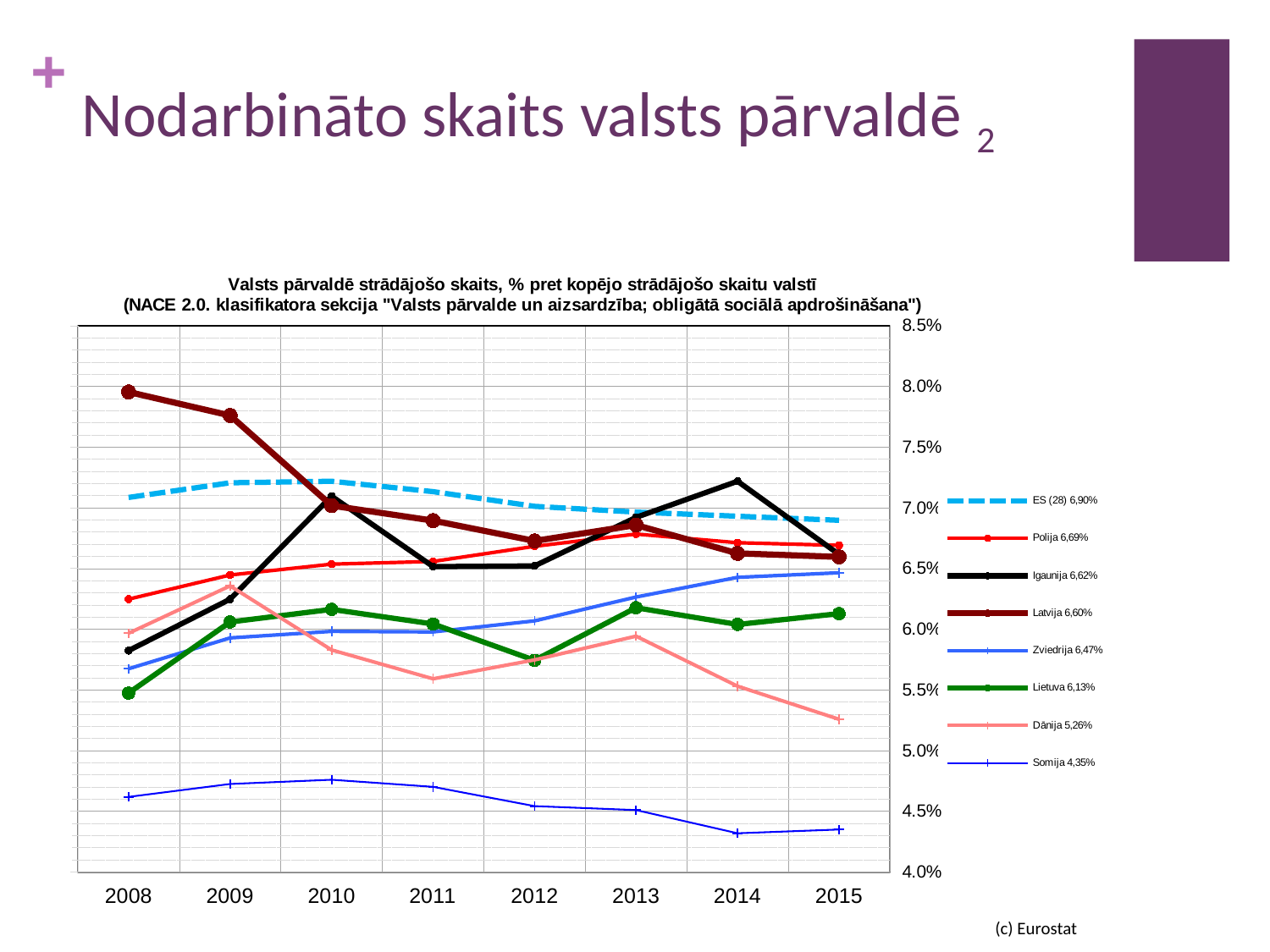
Which is larger in 2014, the value for Igaunija or the value for Latvija? Igaunija Which series has the highest value in 2008? Latvija How many series does the legend list? 8 What value is shown next to ES (28) in the legend? 6,90% What value is shown next to Somija in the legend? 4,35% Which series has the lowest value in 2015? Somija What kind of chart is shown on the slide? line chart Does the value for Dānija rise or fall from 2013 to 2015? fall Is the value for Somija in 2008 greater or less than 5.0%? less How many years are shown along the x axis? 8 Is the value for Lietuva in 2012 greater or less than 6.0%? less Is the value for Latvija in 2008 greater or less than 7.5%? greater